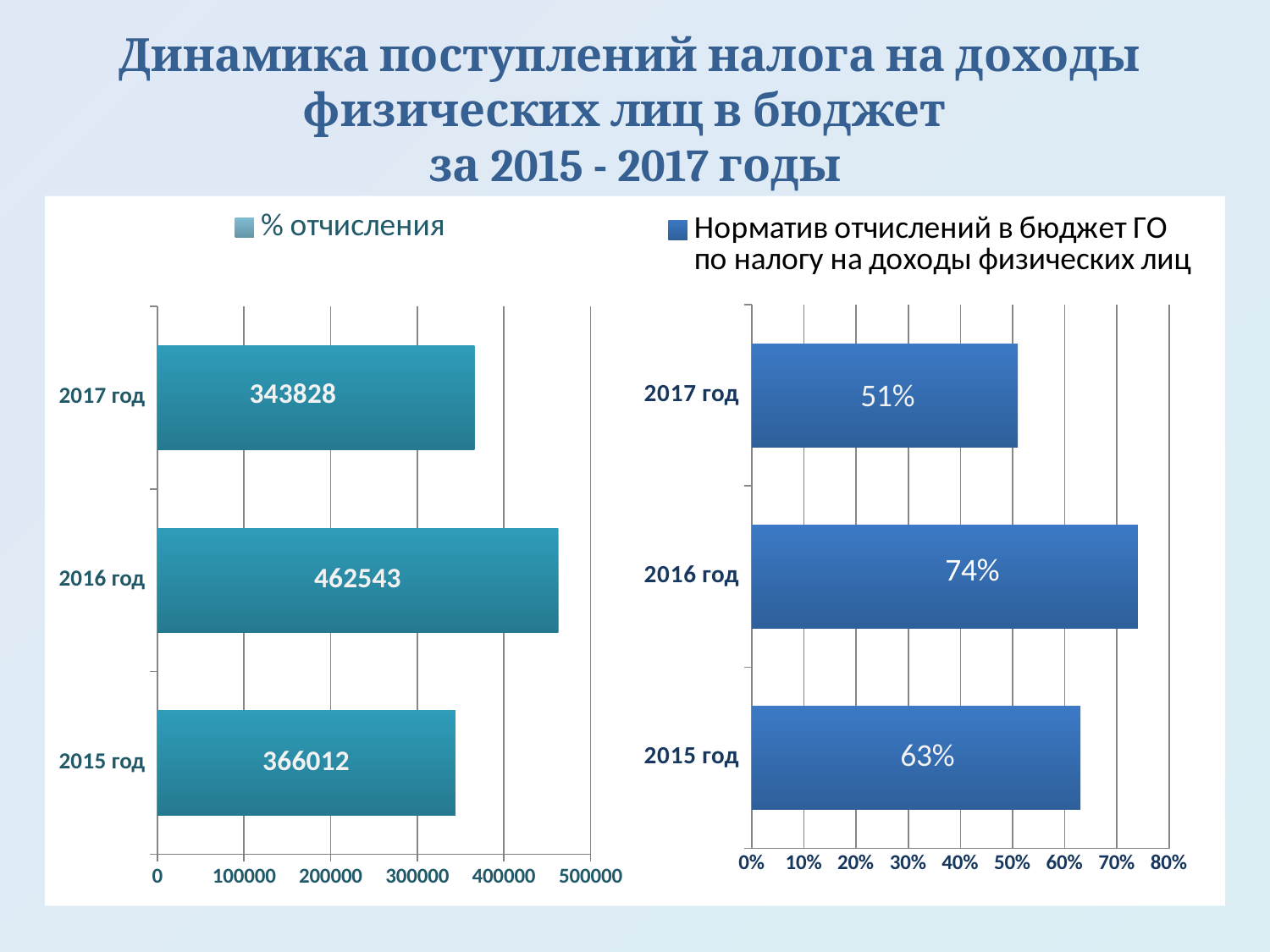
In the left chart (% отчисления), what is the value for 2015 год? 366012 In the right chart (Норматив отчислений в бюджет ГО), which year has the highest value? 2016 год In the right chart (Норматив отчислений в бюджет ГО), what is the difference between the values for 2016 год and 2015 год? 11% In the right chart (Норматив отчислений в бюджет ГО), is the value for 2015 год greater or less than 60%? greater In the left chart (% отчисления), which is larger: the value for 2015 год or 2017 год? 2015 год What is the legend entry of the left chart? % отчисления How many years are shown in the left chart (% отчисления)? 3 In the right chart (Норматив отчислений в бюджет ГО), what is the value for 2017 год? 51% What type of chart is the right chart (Норматив отчислений в бюджет ГО)? bar chart In the left chart (% отчисления), what is the difference between the values for 2016 год and 2017 год? 118715 In the left chart (% отчисления), which year has the lowest value? 2017 год In the left chart (% отчисления), what is the value for 2016 год? 462543